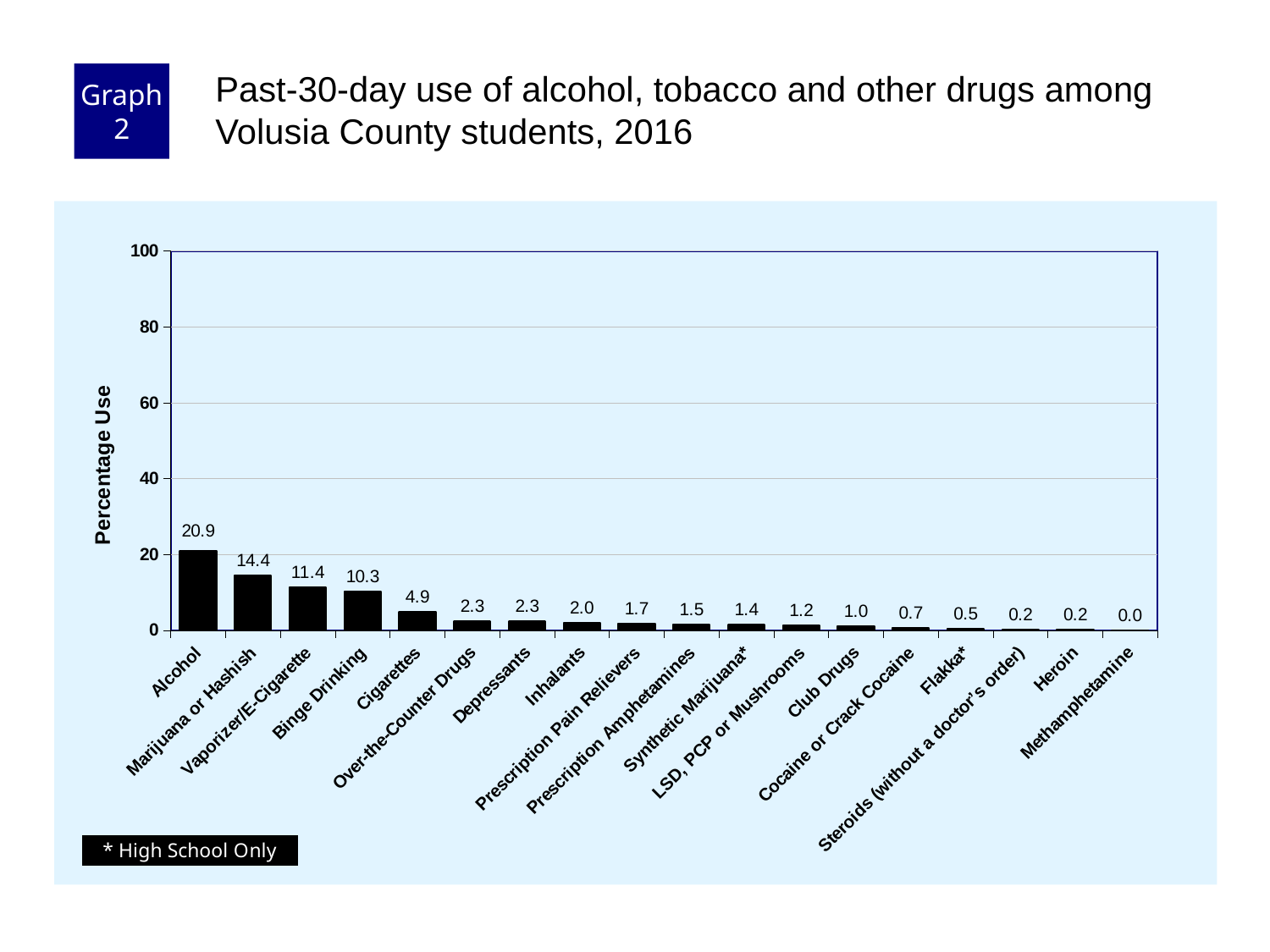
What is the percentage use for Cigarettes? 4.9 What is the percentage use for Alcohol? 20.9 What is the label of the y axis? Percentage Use What type of chart is shown on the slide? Bar chart What is the percentage use for Vaporizer/E-Cigarette? 11.4 Which has a higher percentage use, Inhalants or Prescription Pain Relievers? Inhalants Which category has the lowest percentage use? Methamphetamine What is the difference in percentage use between Alcohol and Marijuana or Hashish? 6.5 What is the percentage use for Club Drugs? 1.0 What is the difference in percentage use between Binge Drinking and Cigarettes? 5.4 Which category has the highest percentage use? Alcohol How many categories are shown on the x axis? 18